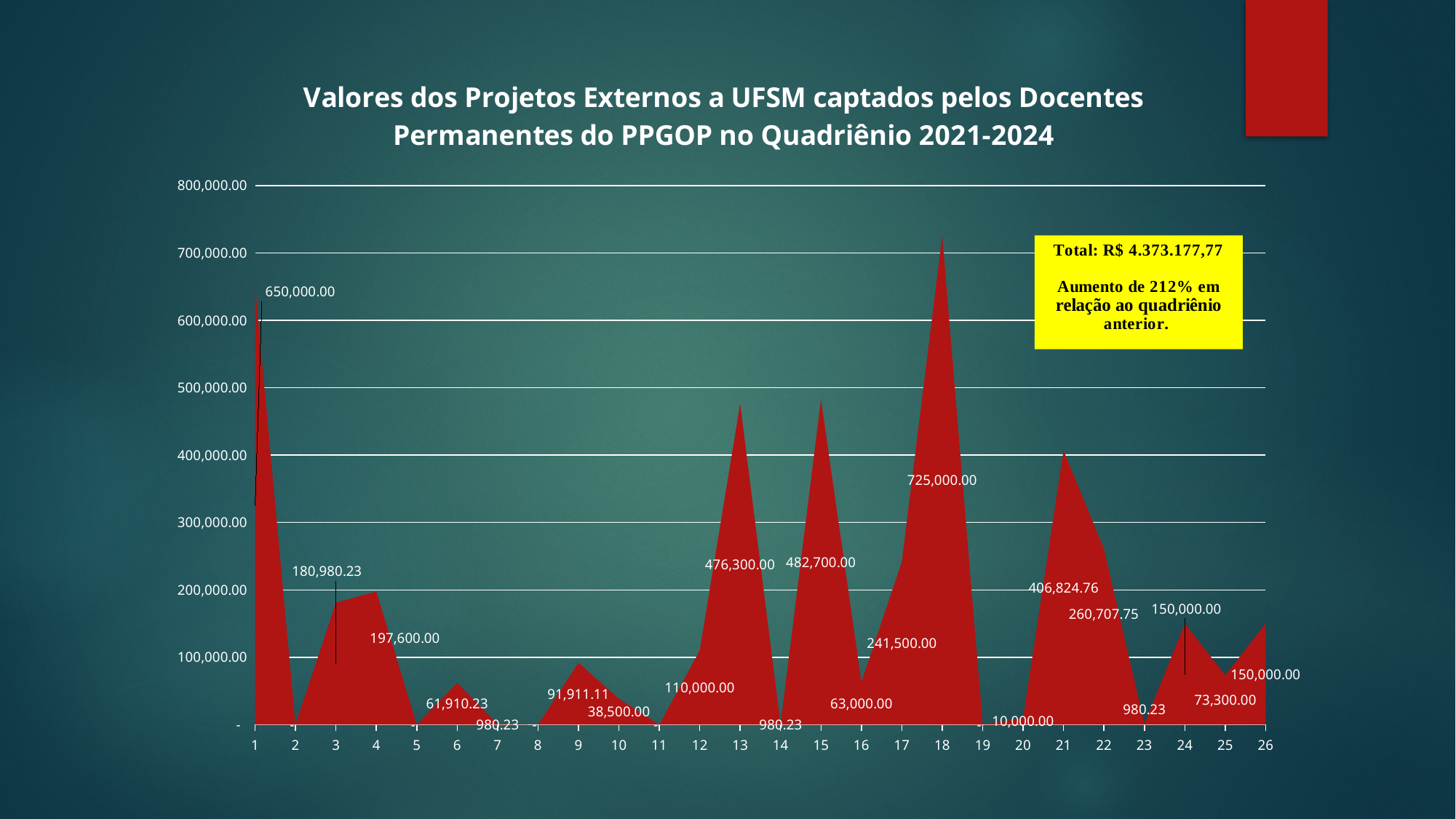
Does the value rise or fall from point 1 to point 2? fall What kind of chart is shown on the slide? area chart Is the value for point 9 greater or less than 100,000.00? less What is the value for point 13? 476,300.00 What is the value for point 1? 650,000.00 How many points are plotted along the x axis? 26 What is the difference between the values for point 18 and point 1? 75,000.00 What is the value for point 18? 725,000.00 Which is larger, the value for point 1 or the value for point 18? point 18 Which point has the highest value? 18 According to the text box on the chart, what is the total value? R$ 4.373.177,77 What is the title of the chart? Valores dos Projetos Externos a UFSM captados pelos Docentes Permanentes do PPGOP no Quadriênio 2021-2024